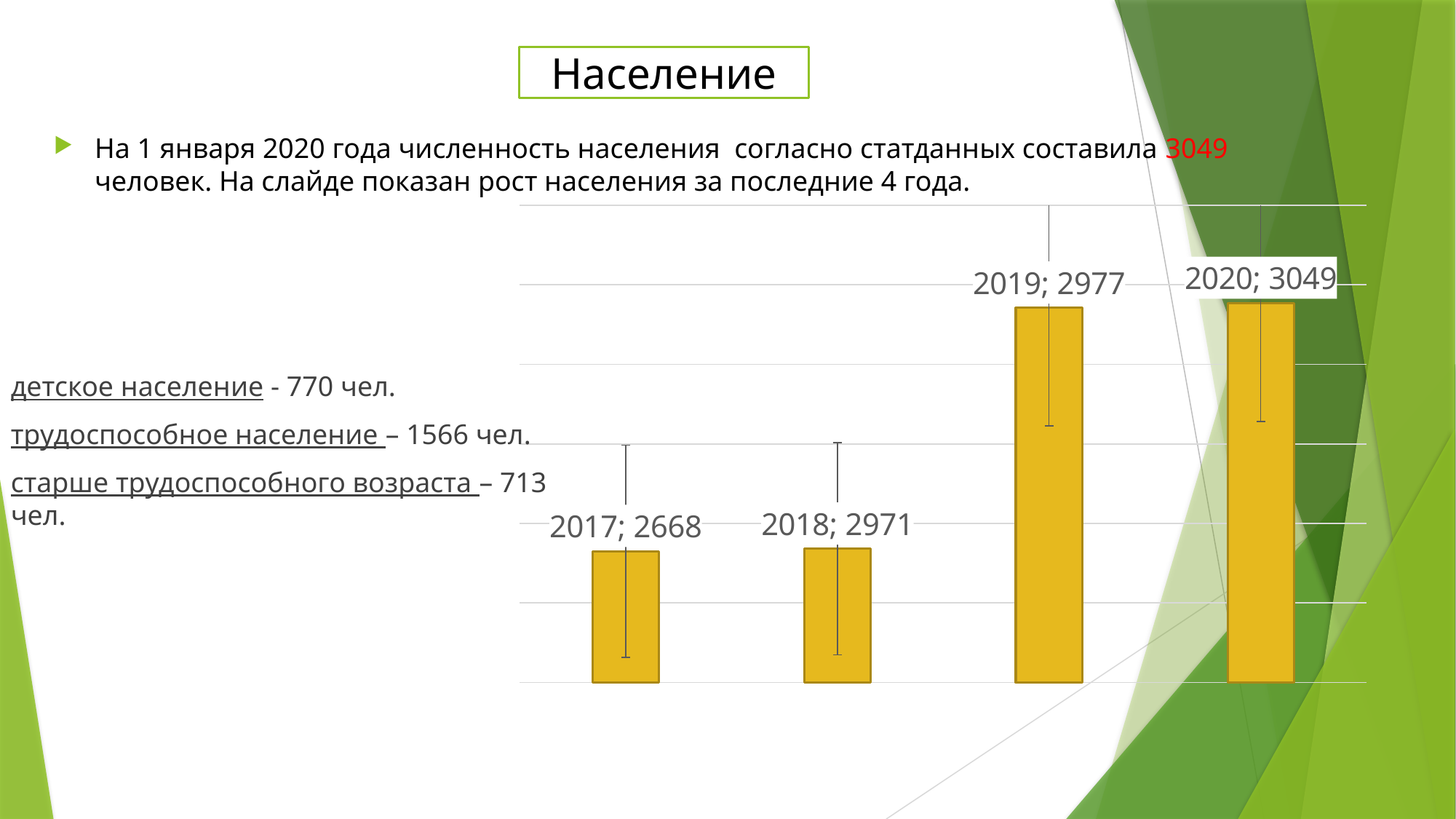
What is the population value shown for 2019? 2977 What is the population value shown for 2018? 2971 Which year has the lowest population value in the chart? 2017 What is the difference between the population values for 2020 and 2017? 381 Do the population values rise or fall from 2017 to 2020? rise What is the difference between the population values for 2018 and 2017? 303 What is the population value shown for 2017? 2668 Which year has the highest population value in the chart? 2020 How many years (bars) are shown in the chart? 4 Which is larger, the population value for 2017 or for 2020? 2020 What is the population value shown for 2020? 3049 What kind of chart is shown on the slide? bar chart